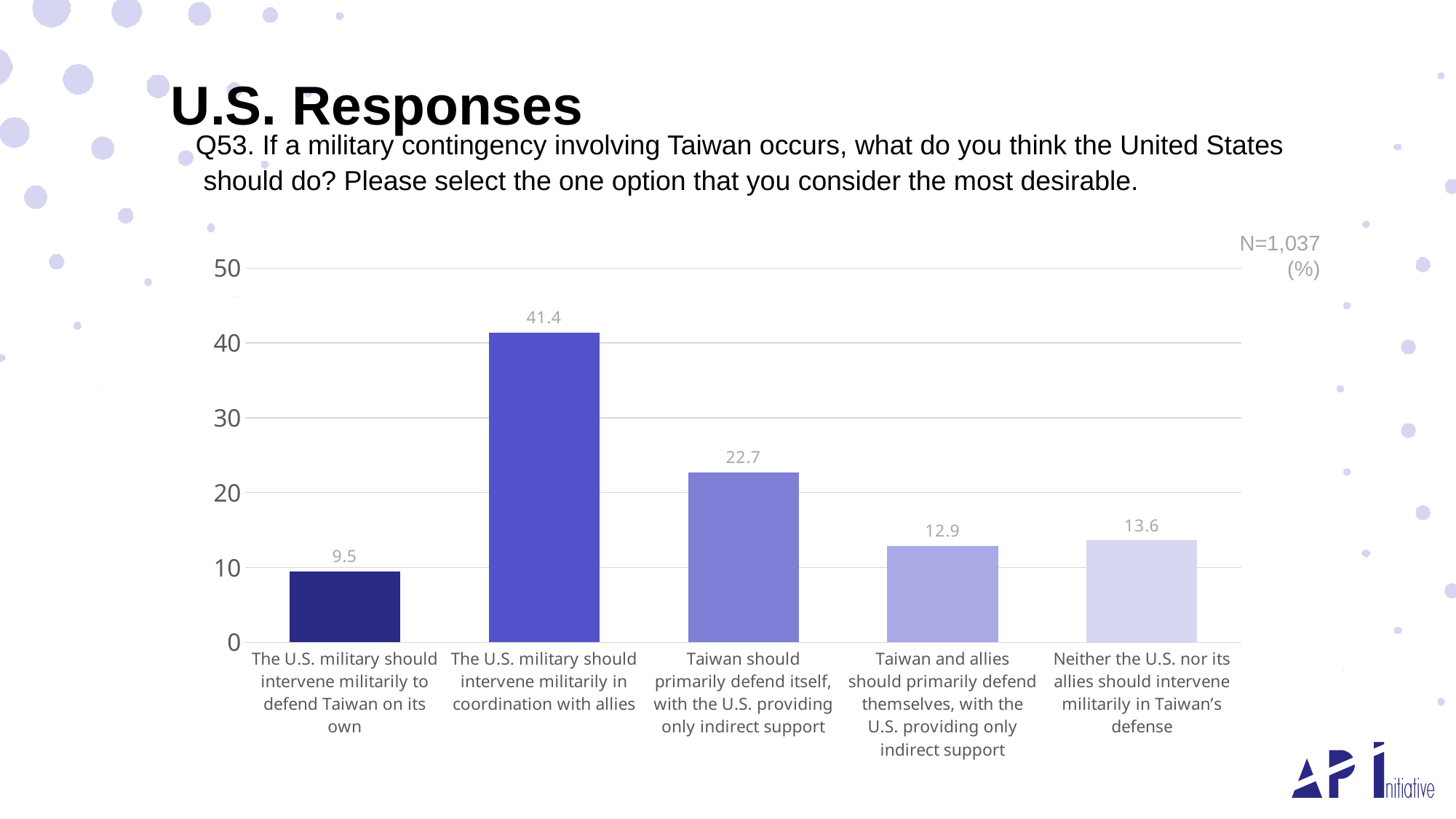
How many response options are shown in the chart? 5 What kind of chart is shown on the slide? bar chart What is the value for "The U.S. military should intervene militarily in coordination with allies"? 41.4 Is the value for "The U.S. military should intervene militarily to defend Taiwan on its own" greater or less than 10? less What is the value for "Neither the U.S. nor its allies should intervene militarily in Taiwan's defense"? 13.6 What is the difference between the values for "The U.S. military should intervene militarily in coordination with allies" and "Taiwan should primarily defend itself, with the U.S. providing only indirect support"? 18.7 What is the sample size (N) shown on the chart? N=1,037 Which is larger: the value for "Taiwan should primarily defend itself, with the U.S. providing only indirect support" or the value for "Taiwan and allies should primarily defend themselves, with the U.S. providing only indirect support"? Taiwan should primarily defend itself, with the U.S. providing only indirect support What is the difference between the values for "Neither the U.S. nor its allies should intervene militarily in Taiwan's defense" and "Taiwan and allies should primarily defend themselves, with the U.S. providing only indirect support"? 0.7 Which option has the highest value? The U.S. military should intervene militarily in coordination with allies What is the value for "Taiwan should primarily defend itself, with the U.S. providing only indirect support"? 22.7 Which option has the lowest value? The U.S. military should intervene militarily to defend Taiwan on its own